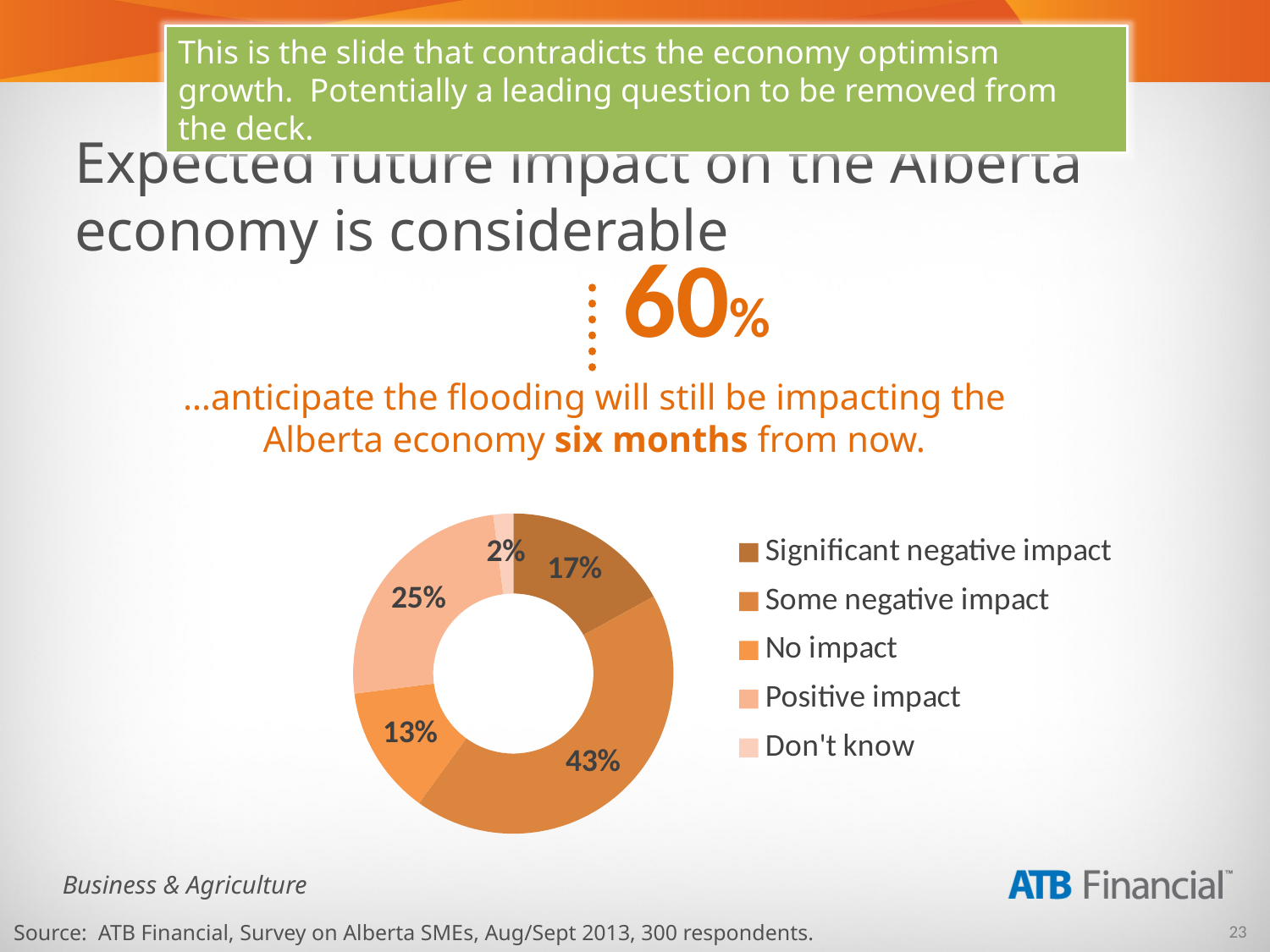
How many categories does the legend list? 5 What is the combined share of 'Significant negative impact' and 'Some negative impact'? 60% What percentage of respondents expect a significant negative impact? 17% What percentage of respondents expect no impact? 13% What kind of chart is shown on the slide? Doughnut (pie) chart Which is larger: the share for 'Positive impact' or the share for 'No impact'? Positive impact What percentage of respondents expect a positive impact? 25% Which response category has the largest share of the chart? Some negative impact Which response category has the smallest share of the chart? Don't know What is the difference between the share for 'Some negative impact' and the share for 'Significant negative impact'? 26% What percentage of respondents answered 'Don't know'? 2% What percentage of respondents expect some negative impact? 43%